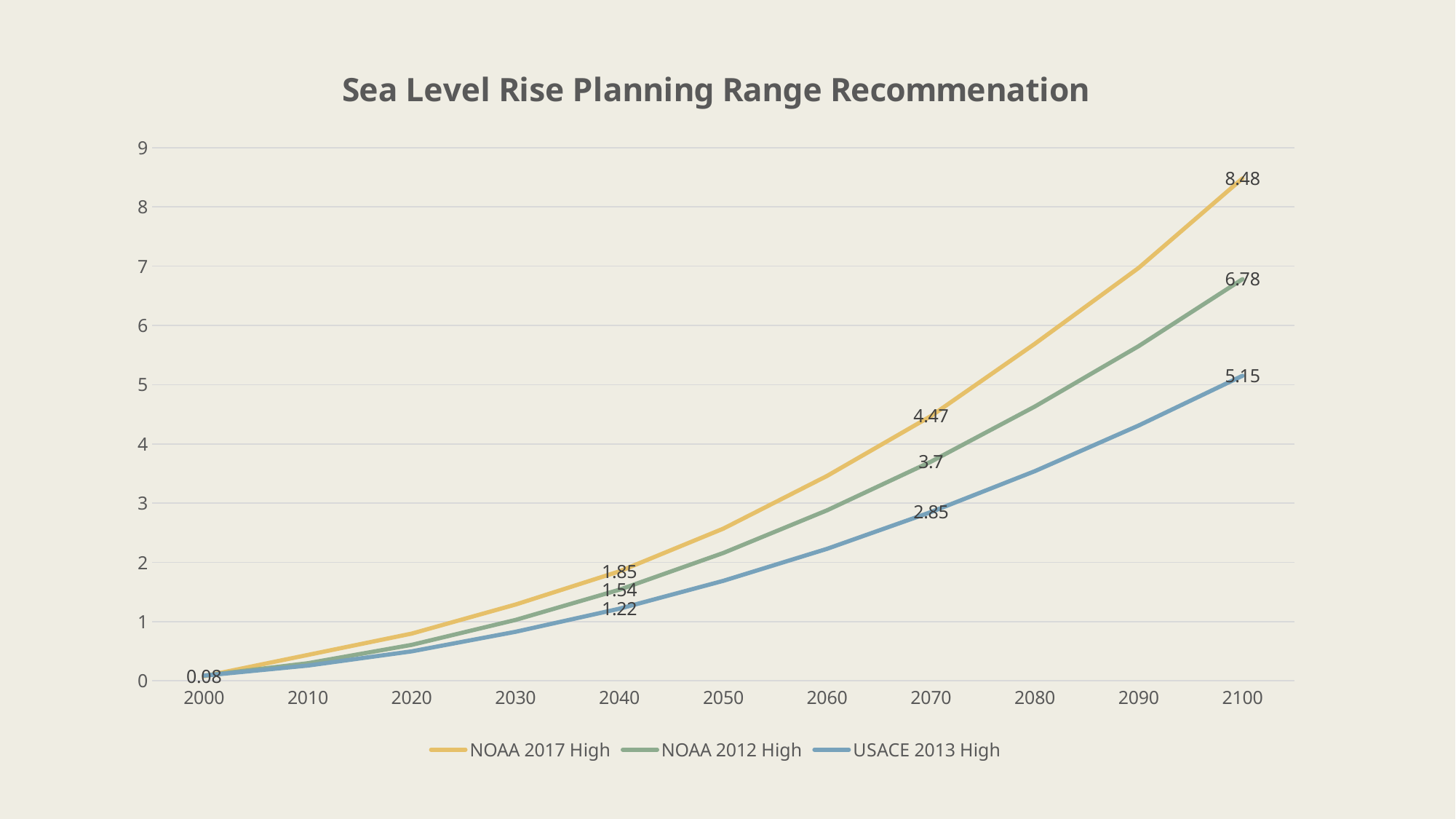
What is the value for NOAA 2017 High in 2100? 8.48 What is the difference between NOAA 2017 High and USACE 2013 High in 2100? 3.33 Is the value for NOAA 2017 High in 2060 greater or less than 3? greater What kind of chart is shown on the slide? Line chart What is the value for USACE 2013 High in 2070? 2.85 What is the value for NOAA 2012 High in 2040? 1.54 Do the values for NOAA 2012 High rise or fall from 2000 to 2100? Rise Which is larger in 2040: NOAA 2012 High or USACE 2013 High? NOAA 2012 High Which series has the lowest value in 2070? USACE 2013 High How many series does the legend list? 3 Which series has the highest value in 2100? NOAA 2017 High How many years are shown on the x axis? 11